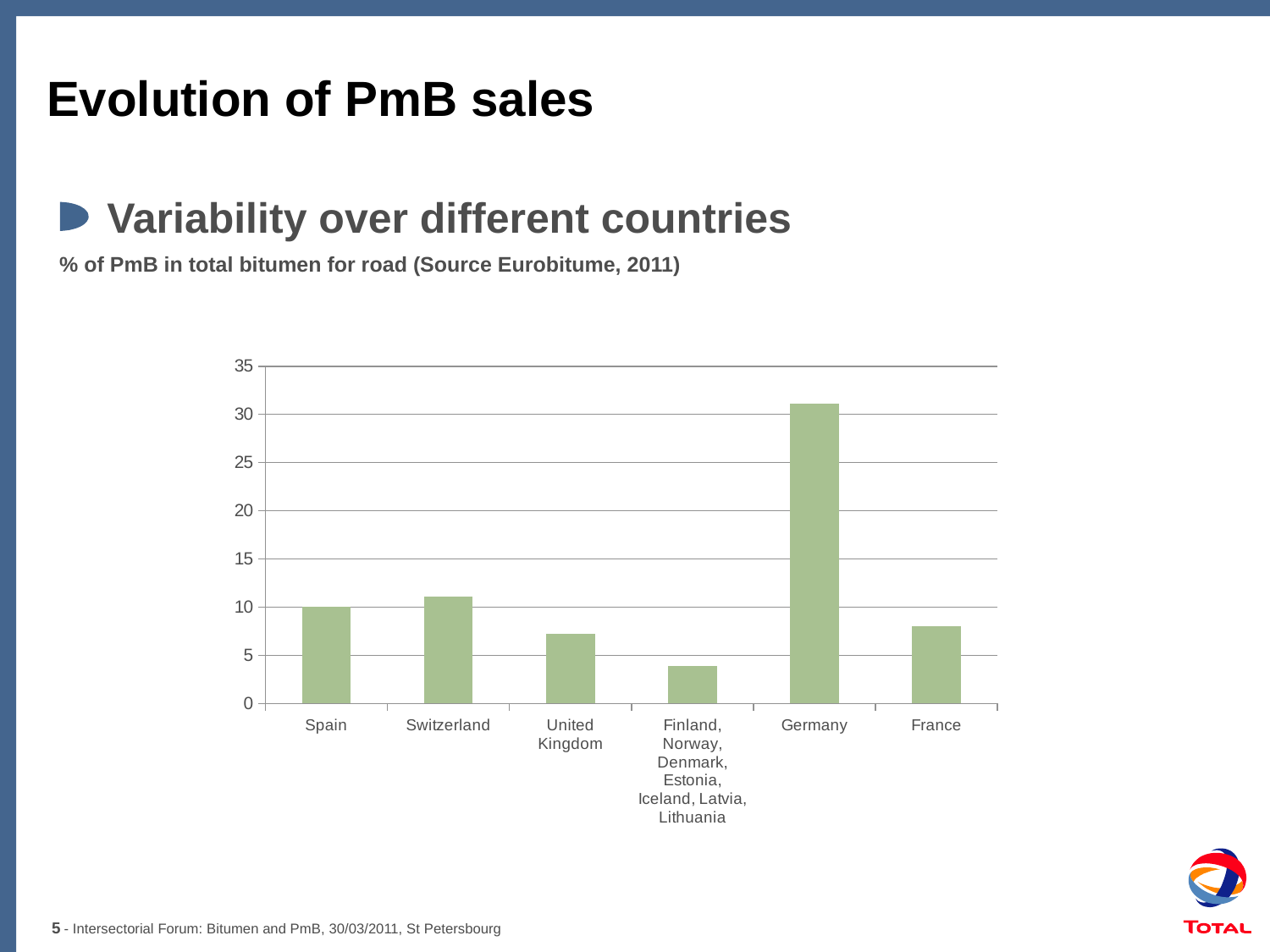
Is the value for the Finland, Norway, Denmark, Estonia, Iceland, Latvia, Lithuania group greater or less than 5? less What is the maximum value shown on the y axis of the chart? 35 Is the value for United Kingdom greater or less than 10? less What kind of chart is shown on the slide? bar chart Which category has the highest value in the chart? Germany Which category has the lowest value in the chart? Finland, Norway, Denmark, Estonia, Iceland, Latvia, Lithuania Which has a larger value, Switzerland or France? Switzerland Which has a larger value, United Kingdom or Germany? Germany How many categories are shown on the x axis of the chart? 6 Is the value for Switzerland greater or less than 10? greater